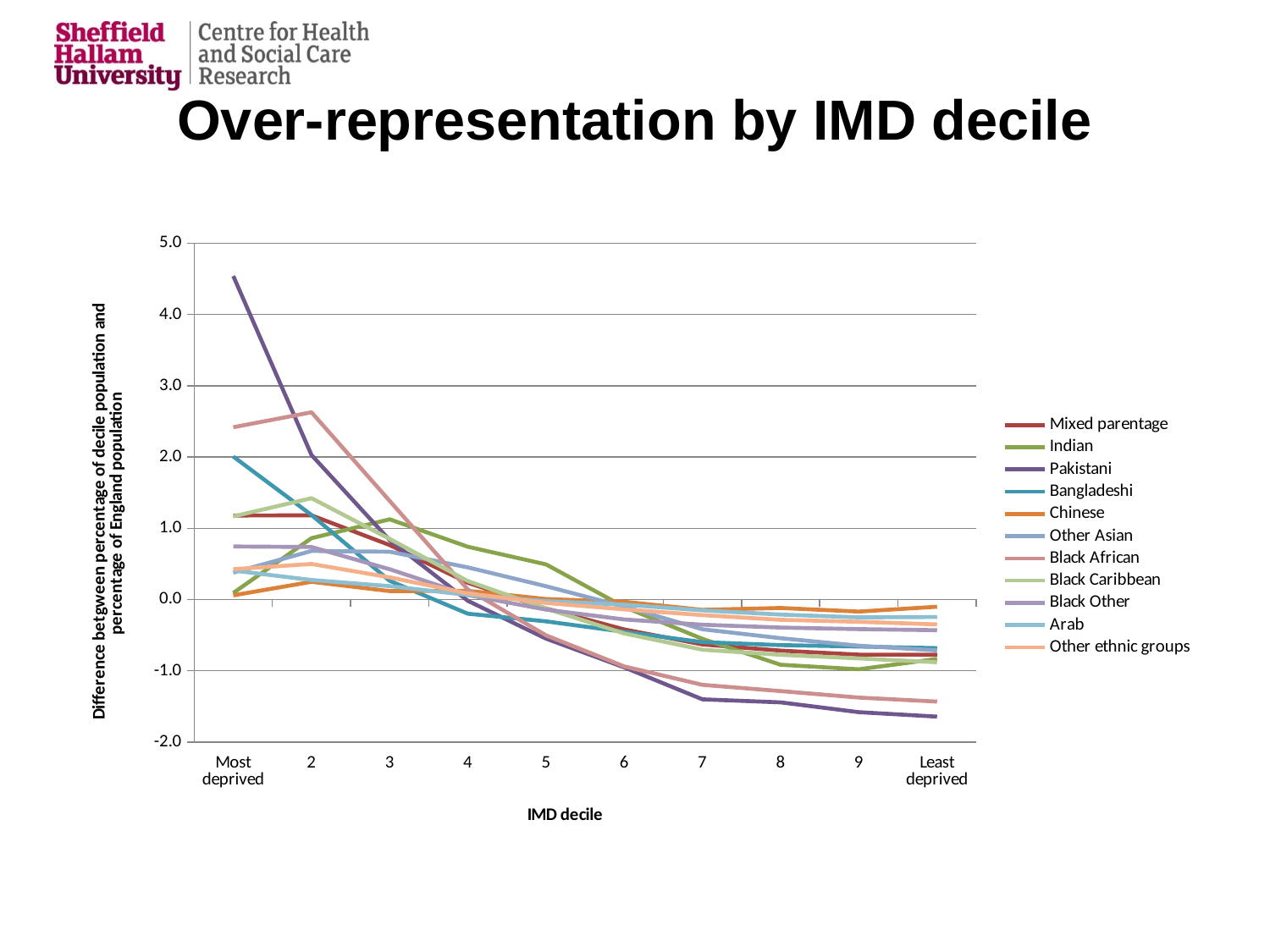
At the Most deprived decile, which is larger: the value for Pakistani or the value for Black African? Pakistani Is the value for Pakistani at the Least deprived decile greater or less than -1.0? less How many IMD decile categories are shown along the x axis? 10 Does the Pakistani line rise or fall from the Most deprived decile to the Least deprived decile? fall Which ethnic group has the highest value at the Most deprived decile? Pakistani Is the value for Chinese at the Least deprived decile greater or less than -1.0? greater What kind of chart is shown on the slide? line chart How many series does the legend list? 11 Is the value for Black African at decile 2 greater or less than 2.0? greater Which ethnic group has the lowest value at the Least deprived decile? Pakistani What is the title of the chart on the slide? Over-representation by IMD decile